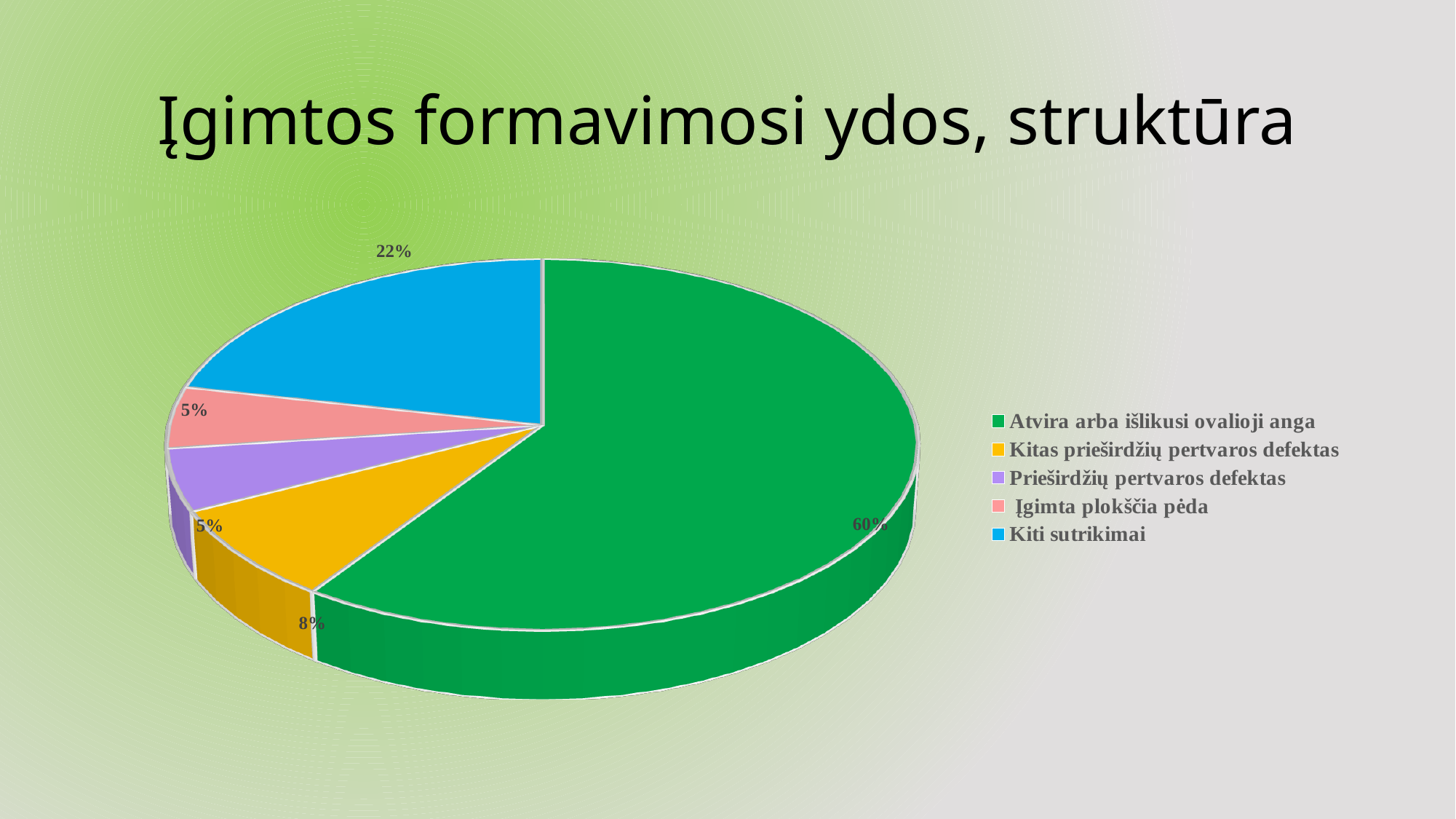
What share of the pie does "Įgimta plokščia pėda" have? 5% What is the difference in percentage points between the shares of "Atvira arba išlikusi ovalioji anga" and "Kiti sutrikimai"? 38 What is the difference in percentage points between the shares of "Kiti sutrikimai" and "Kitas prieširdžių pertvaros defektas"? 14 What share of the pie does "Kiti sutrikimai" have? 22% Which category has the larger share: "Kiti sutrikimai" or "Kitas prieširdžių pertvaros defektas"? Kiti sutrikimai What share of the pie does "Prieširdžių pertvaros defektas" have? 5% How many categories are shown in the pie chart? 5 What is the title of the slide containing the chart? Įgimtos formavimosi ydos, struktūra Which category has the largest slice of the pie? Atvira arba išlikusi ovalioji anga What type of chart is shown on the slide? Pie chart